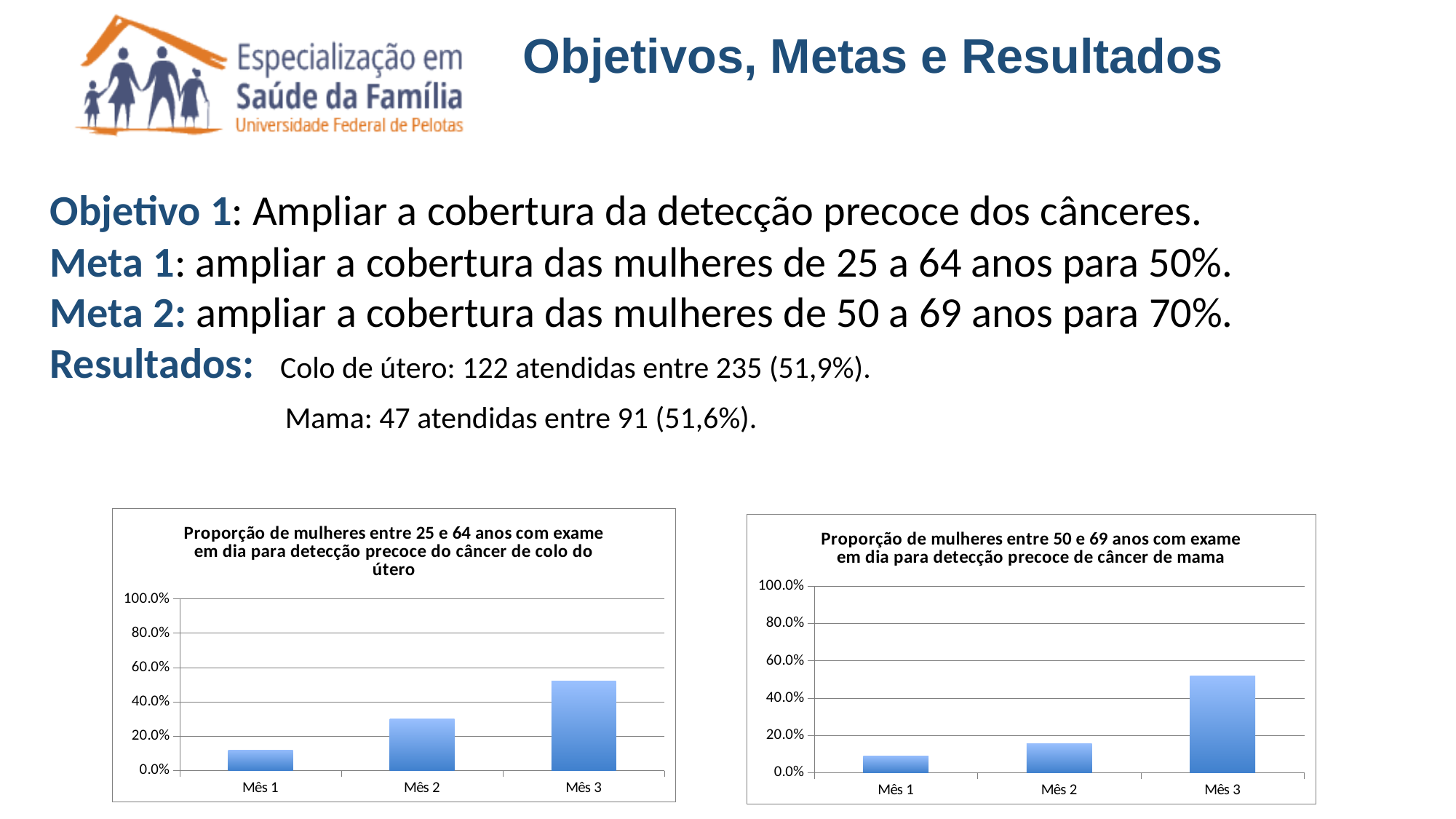
In the left chart (Proporção de mulheres entre 25 e 64 anos), is the value for Mês 3 greater or less than 40.0%? greater What kind of chart is the left chart (Proporção de mulheres entre 25 e 64 anos)? bar chart In the right chart (Proporção de mulheres entre 50 e 69 anos), is the value for Mês 3 greater or less than 40.0%? greater In the right chart (Proporção de mulheres entre 50 e 69 anos), is the value for Mês 2 greater or less than 20.0%? less In the right chart (Proporção de mulheres entre 50 e 69 anos), which month has the lowest value? Mês 1 In the left chart (Proporção de mulheres entre 25 e 64 anos), which month has the lowest value? Mês 1 In the right chart (Proporção de mulheres entre 50 e 69 anos), which month has the highest value? Mês 3 In the left chart (Proporção de mulheres entre 25 e 64 anos), which month has the highest value? Mês 3 In the right chart (Proporção de mulheres entre 50 e 69 anos), how many months are shown on the x axis? 3 In the left chart (Proporção de mulheres entre 25 e 64 anos), do the values rise or fall from Mês 1 to Mês 3? rise